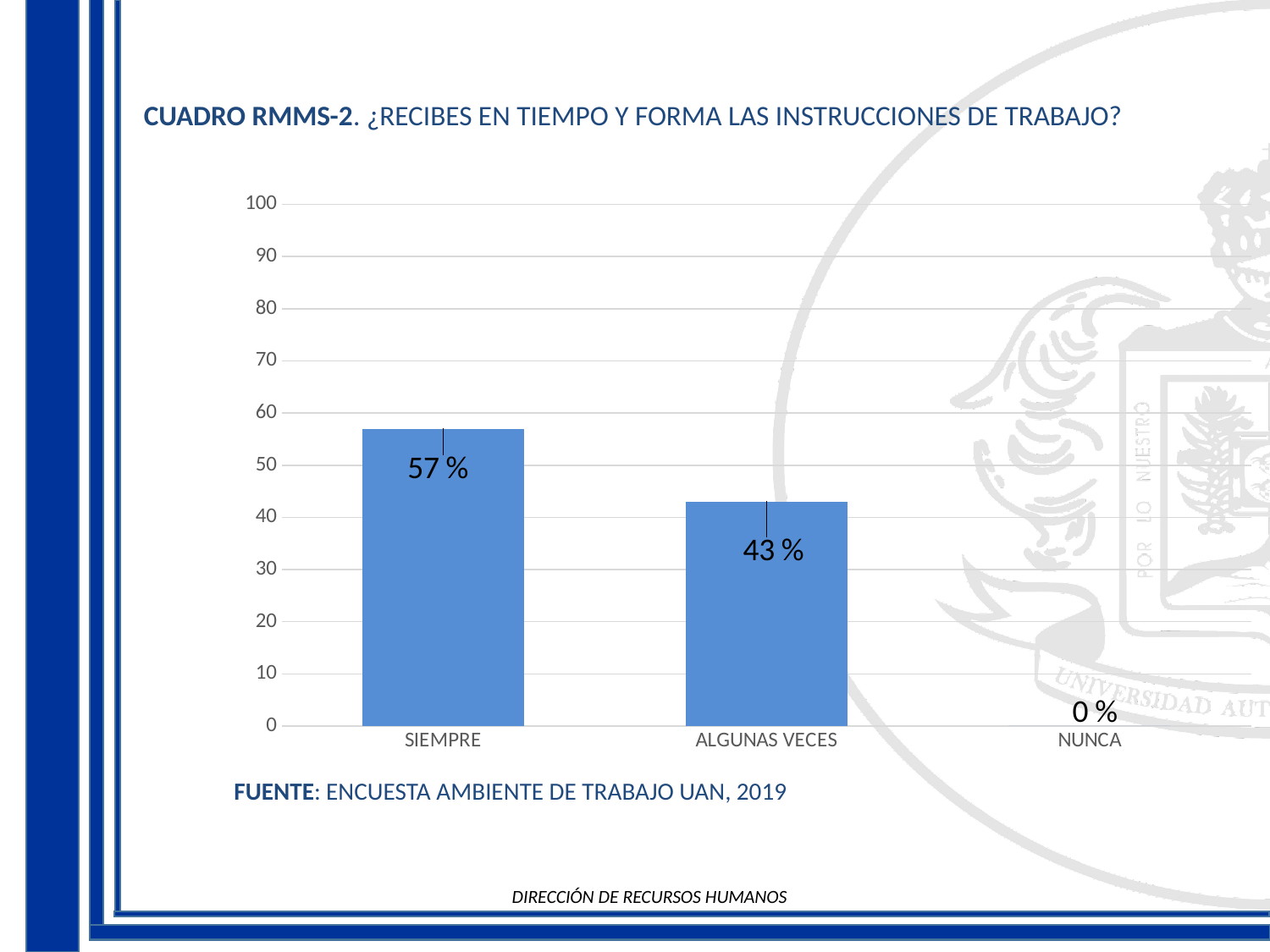
Which is larger, the value for SIEMPRE or the value for ALGUNAS VECES? SIEMPRE What source is cited below the chart? ENCUESTA AMBIENTE DE TRABAJO UAN, 2019 Which category has the lowest value? NUNCA What is the value for ALGUNAS VECES? 43 % What is the difference between the values for SIEMPRE and ALGUNAS VECES? 14 % Is the value for SIEMPRE greater or less than 50? greater What is the value for SIEMPRE? 57 % Is the value for ALGUNAS VECES greater or less than 50? less How many categories are shown on the x axis? 3 What kind of chart is shown on the slide? bar chart What is the value for NUNCA? 0 % Which category has the highest value? SIEMPRE